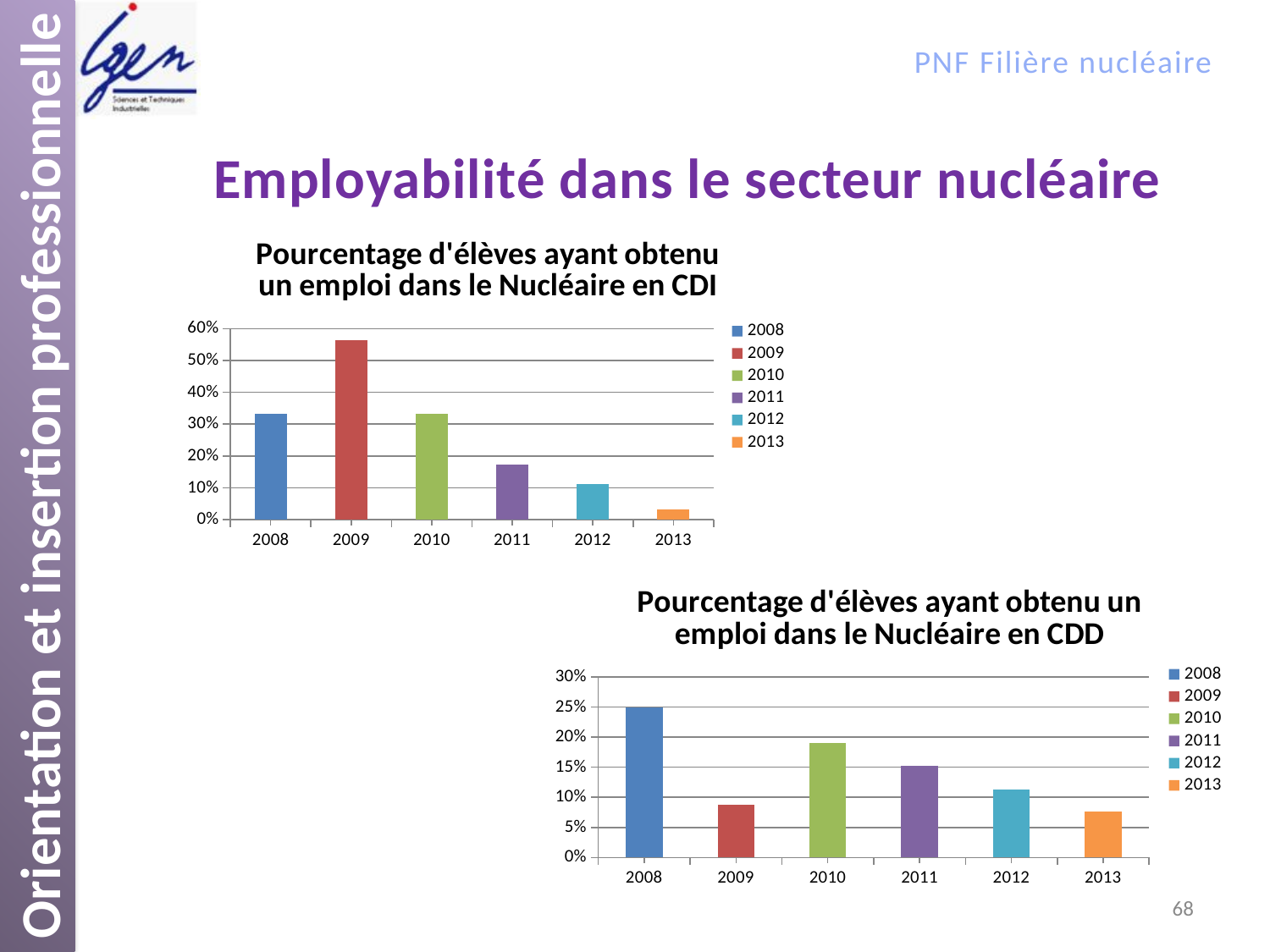
In the CDI chart, is the value for 2013 greater or less than 10%? less In the CDD chart, is the value for 2010 greater or less than 15%? greater In the chart 'Pourcentage d'élèves ayant obtenu un emploi dans le Nucléaire en CDI', which year has the highest value? 2009 How many years are shown on the x axis of the CDI chart? 6 In the chart 'Pourcentage d'élèves ayant obtenu un emploi dans le Nucléaire en CDD', which year has the highest value? 2008 In the CDI chart, is the value for 2011 greater or less than 20%? less What type of chart is the CDD chart? bar chart In the CDD chart, which is larger, the value for 2010 or the value for 2011? 2010 In the chart 'Pourcentage d'élèves ayant obtenu un emploi dans le Nucléaire en CDI', which year has the lowest value? 2013 In the CDI chart, which is larger, the value for 2011 or the value for 2012? 2011